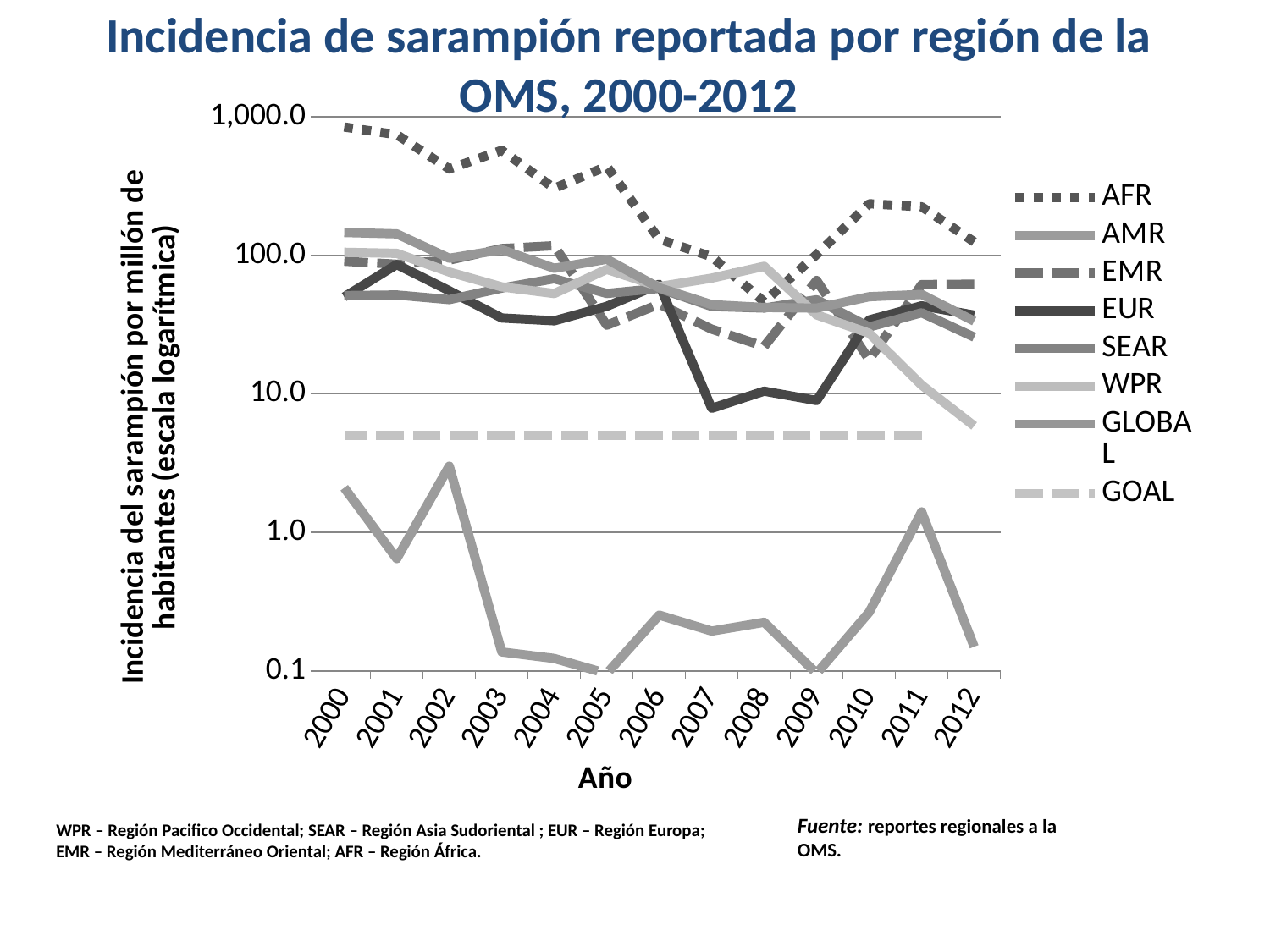
Is the value for AMR in 2002 greater or less than 10.0? less Is the value for WPR in 2012 greater or less than 10.0? less Does the WPR series rise or fall between 2008 and 2012? fall How many series does the legend list? 8 Is the GOAL line greater or less than 10.0? less Which region has the highest reported measles incidence in 2000? AFR Which series has the lowest value in 2000? AMR What kind of chart is shown on the slide? line chart How many years are shown along the x axis? 13 What is the label of the x axis? Año